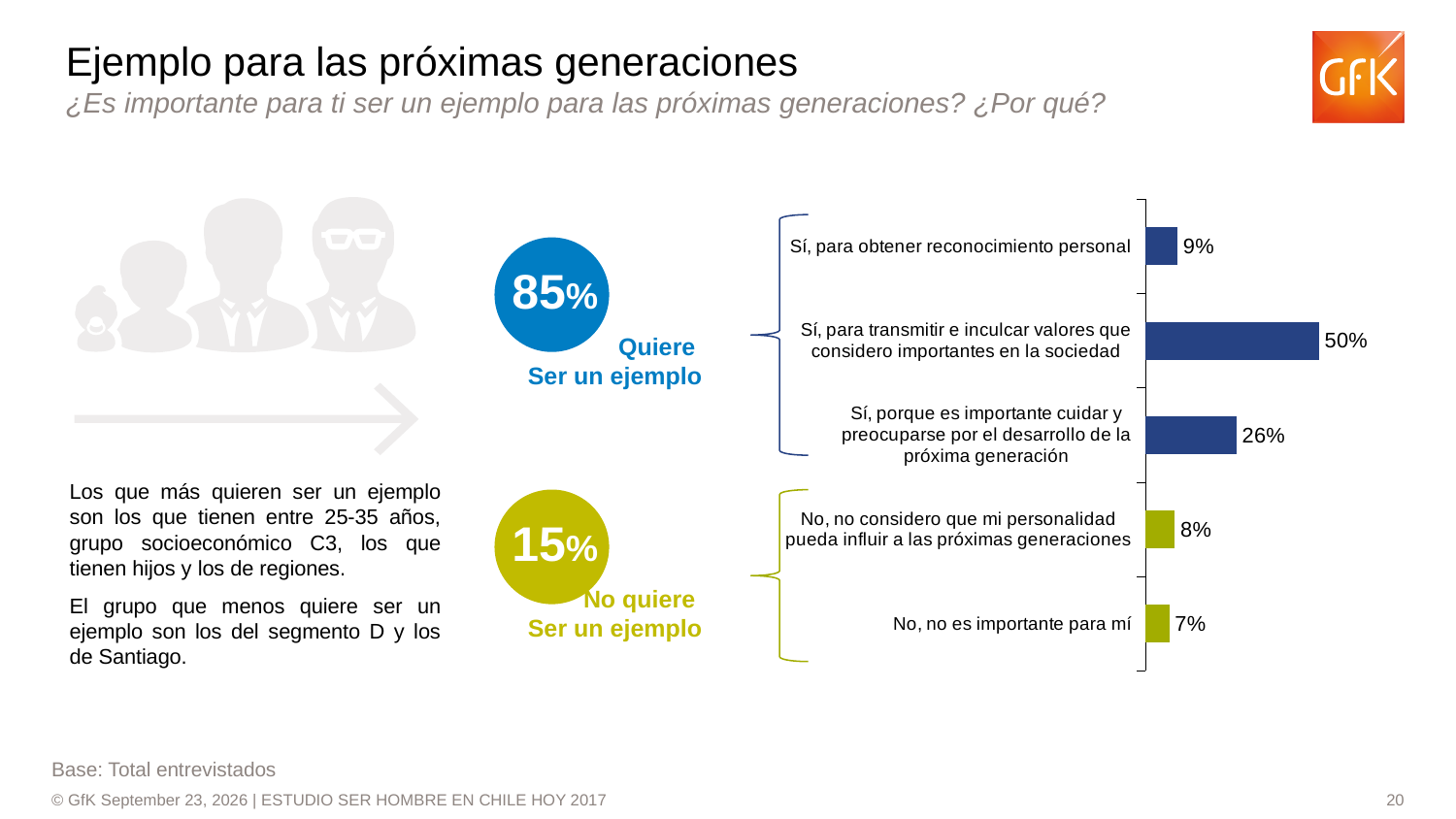
How many categories are shown in the bar chart? 5 Which category has the lowest value? No, no es importante para mí Which category has the highest value? Sí, para transmitir e inculcar valores que considero importantes en la sociedad What percentage is shown in the blue circle labelled "Quiere Ser un ejemplo"? 85% What is the value for "Sí, porque es importante cuidar y preocuparse por el desarrollo de la próxima generación"? 26% What kind of chart is shown on the slide? Bar chart What is the value for "Sí, para transmitir e inculcar valores que considero importantes en la sociedad"? 50% What is the difference between the values for "Sí, para transmitir e inculcar valores que considero importantes en la sociedad" and "Sí, porque es importante cuidar y preocuparse por el desarrollo de la próxima generación"? 24% What is the value for "No, no es importante para mí"? 7% What is the total of the two "No" categories in the bar chart? 15% What is the value for "Sí, para obtener reconocimiento personal"? 9% Which is larger: the value for "Sí, para obtener reconocimiento personal" or "No, no considero que mi personalidad pueda influir a las próximas generaciones"? Sí, para obtener reconocimiento personal